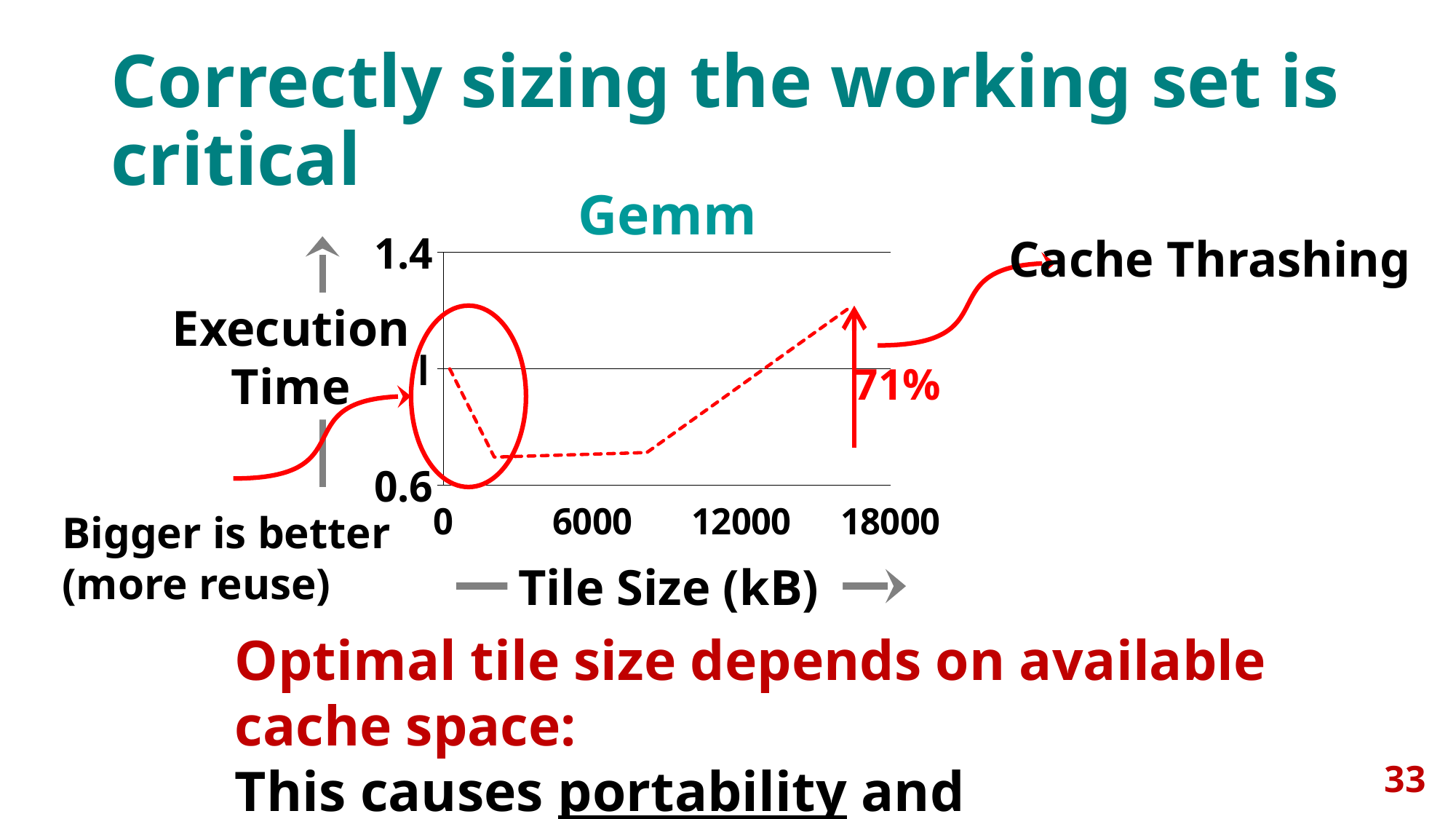
How does execution time change as tile size increases from about 8500 kB to about 17000 kB? it rises Is the execution time at the largest plotted tile size (near 17000 kB) greater or less than 1? greater What is the largest tick value shown on the x axis of the chart? 18000 Is the execution time at a tile size of 6000 kB greater or less than 1? less What is the label of the x axis of the chart? Tile Size (kB) What percentage is annotated next to the red arrow at the right end of the line? 71% Is the execution time at the largest plotted tile size greater or less than 1.4? less What is the title of the chart? Gemm What kind of chart is shown on the slide? line chart What is the highest value shown on the y axis of the chart? 1.4 How does execution time change as tile size increases from 0 to about 2500 kB? it falls